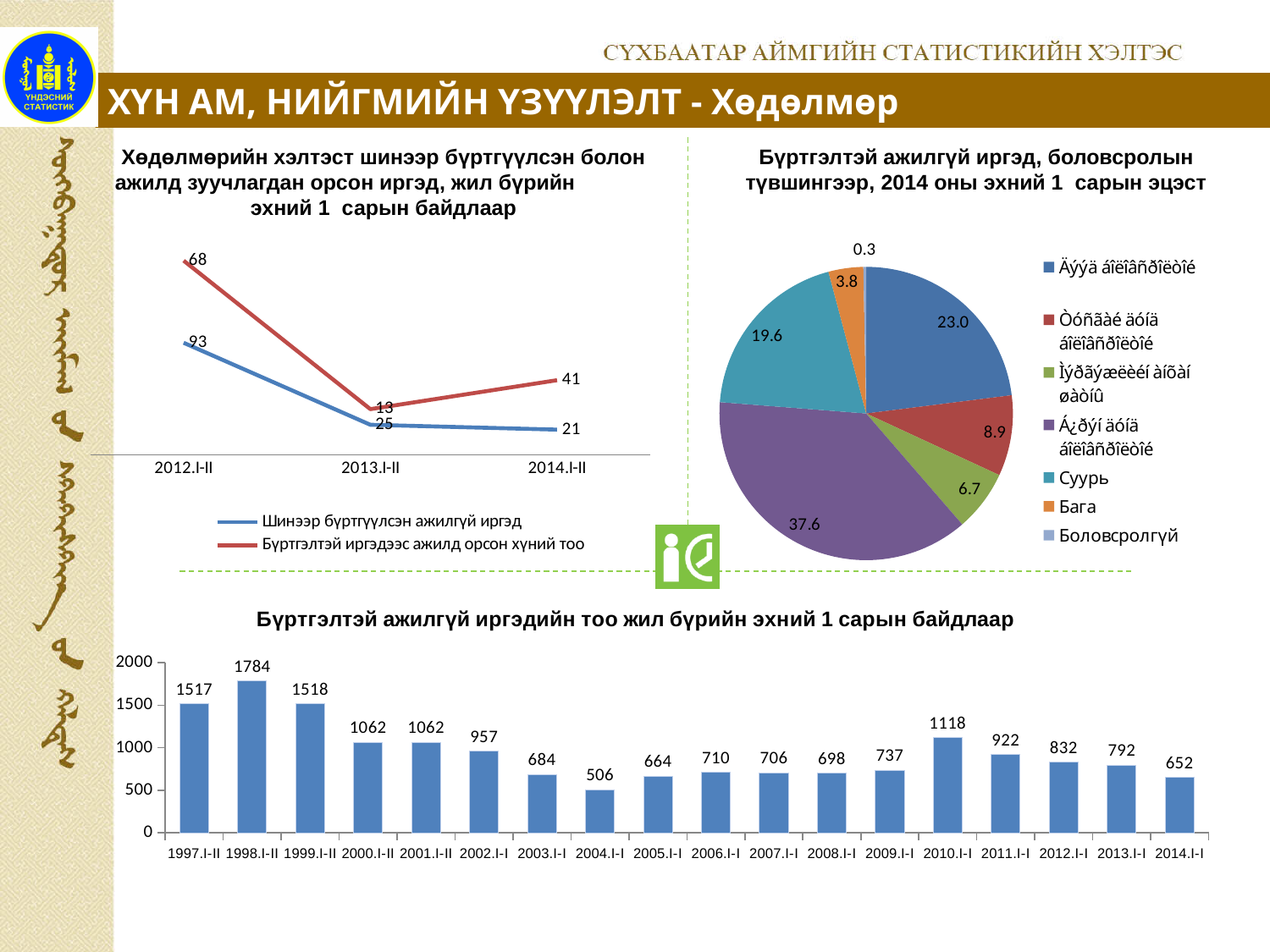
In the top-left line chart, which series has the larger value at 2014.I-II? Бүртгэлтэй иргэдээс ажилд орсон хүний тоо In the top-left line chart, what is the value of the series 'Шинээр бүртгүүлсэн ажилгүй иргэд' for 2012.I-II? 93 In the bottom bar chart, how many bars (categories) are shown? 18 In the top-right pie chart, what is the value of the 'Суурь' slice? 19.6 In the bottom bar chart, which category has the lowest value? 2004.I-I In the bottom bar chart (Бүртгэлтэй ажилгүй иргэдийн тоо), what is the value for 2010.I-I? 1118 In the top-left line chart, what is the value of the series 'Бүртгэлтэй иргэдээс ажилд орсон хүний тоо' for 2014.I-II? 41 What type of chart is the top-right chart (Бүртгэлтэй ажилгүй иргэд, боловсролын түвшингээр)? pie chart In the bottom bar chart, which category has the highest value? 1998.I-II In the bottom bar chart, what is the difference between the values for 1998.I-II and 2014.I-I? 1132 In the top-left line chart, how many series does the legend list? 2 In the bottom bar chart, is the value for 2011.I-I greater or less than 1000? less